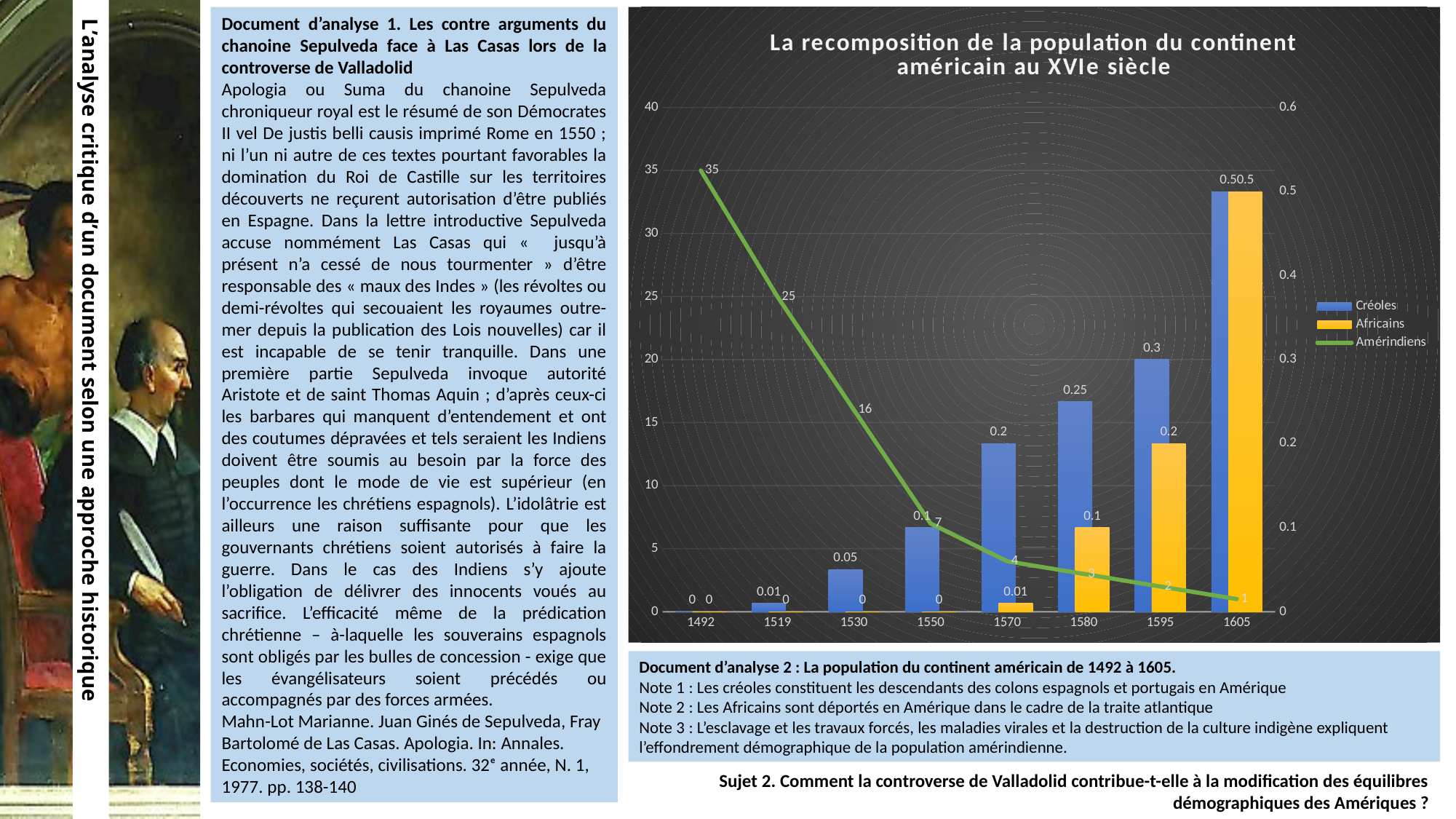
What is the value for Amérindiens in 1492? 35 What is the value for Africains in 1580? 0.1 What is the value for Créoles in 1595? 0.3 Does the Amérindiens series rise or fall from 1492 to 1605? fall What is the title of the chart? La recomposition de la population du continent américain au XVIe siècle What is the difference between the Amérindiens values in 1492 and 1519? 10 In which year is the Amérindiens value lowest? 1605 In which year is the Créoles value highest? 1605 How many series does the chart legend list? 3 Which is larger in 1580, the Créoles value or the Africains value? Créoles What is the value for Amérindiens in 1550? 7 How many years are shown along the x axis of the chart? 8